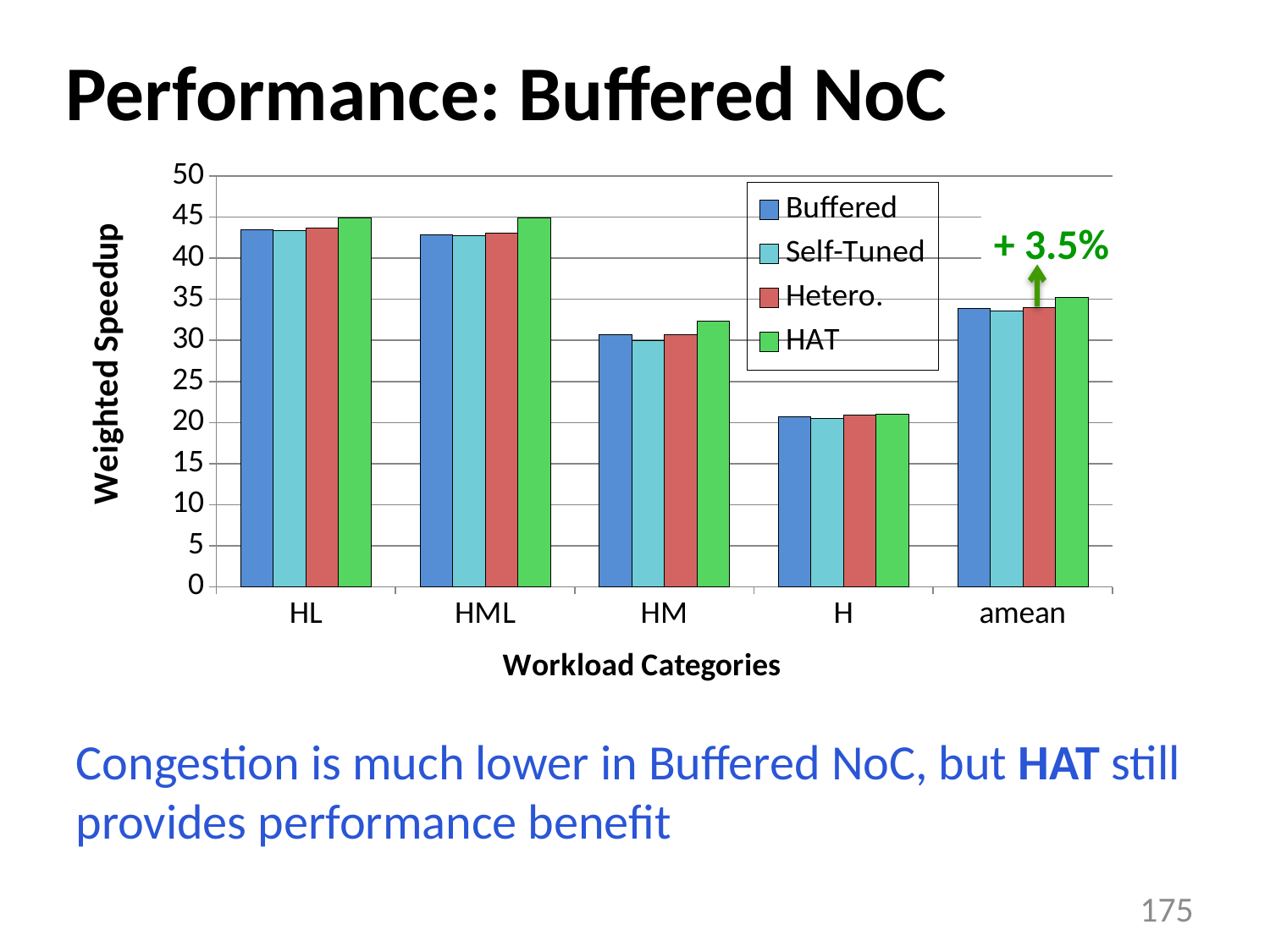
Which workload category has the lowest weighted speedup for the Buffered series? H How many workload categories are shown on the x axis? 5 Which workload category has the lowest weighted speedup for the HAT series? H Is the Buffered value for H greater or less than 25? less How many series does the legend list? 4 What percentage improvement is annotated above the amean bars? + 3.5% For the HAT series, which is larger: HL or HM? HL Is the Buffered value for amean greater or less than 30? greater For the Buffered series, which is larger: HM or H? HM Is the HAT value for HM greater or less than 30? greater What kind of chart is shown on the slide? bar chart